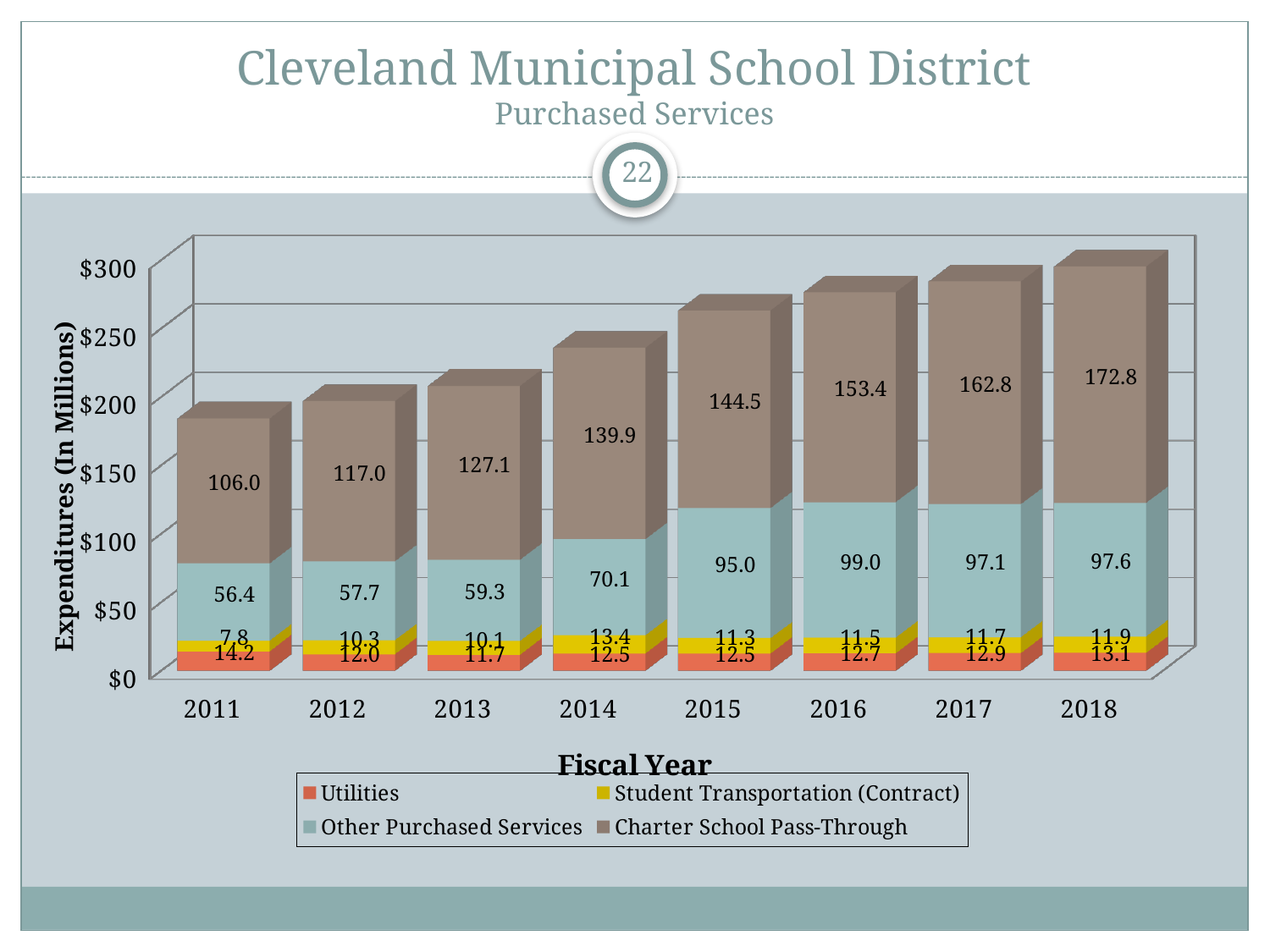
What is the Charter School Pass-Through value for fiscal year 2014? 139.9 What is the difference between the Charter School Pass-Through values for 2018 and 2011? 66.8 How many series does the legend list? 4 How many fiscal years are shown on the x axis? 8 In which fiscal year is the Student Transportation (Contract) value lowest? 2011 Does the Charter School Pass-Through value rise or fall from 2011 to 2018? rise Which is larger, the Other Purchased Services value for 2016 or for 2018? 2016 What is the total of the stacked bar for fiscal year 2012? 197.0 What is the Utilities value for fiscal year 2011? 14.2 What is the Other Purchased Services value for fiscal year 2016? 99.0 In which fiscal year is the Charter School Pass-Through value highest? 2018 What type of chart is shown on the slide? stacked bar chart